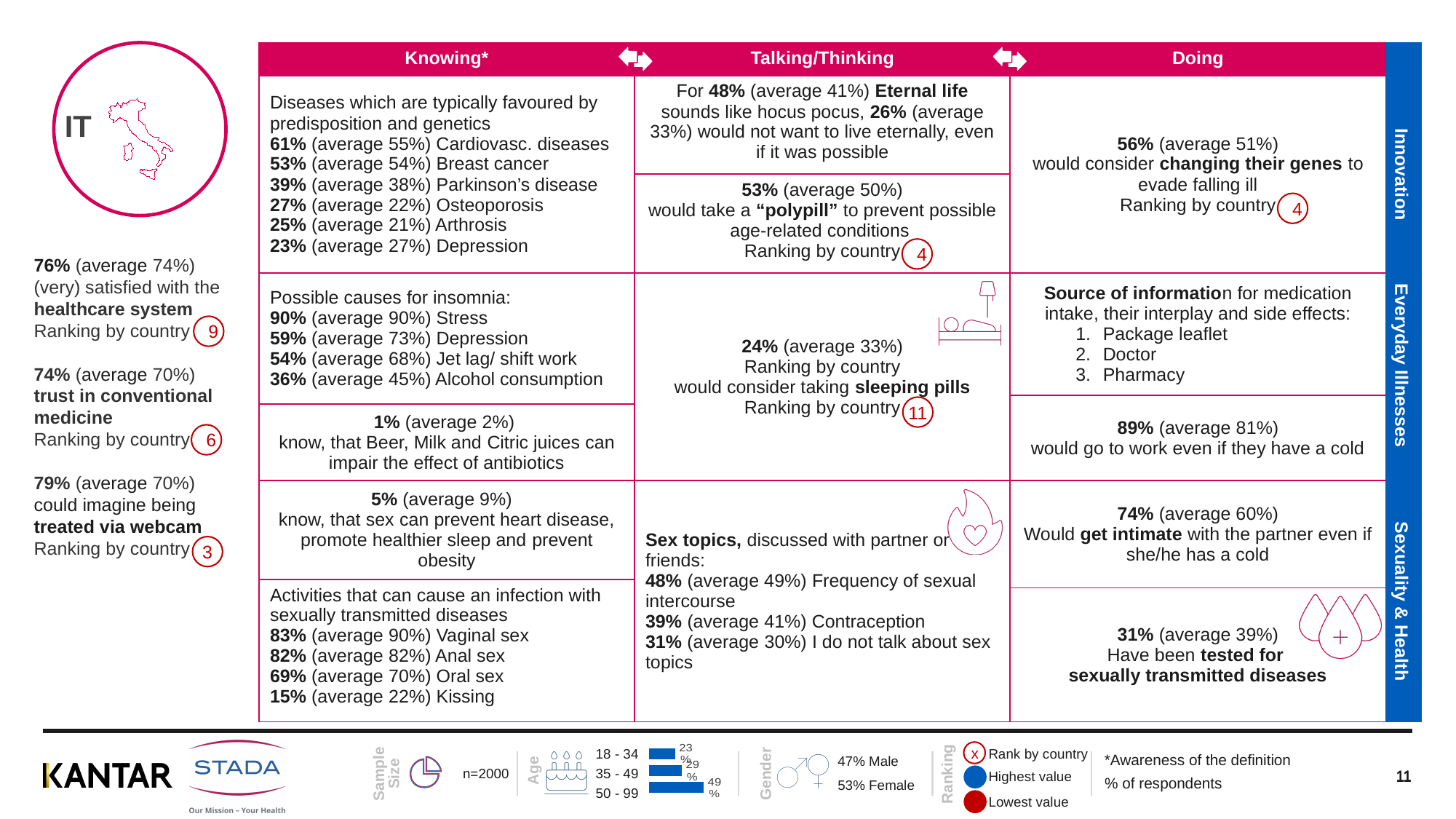
What does the small bar chart at the bottom of the slide show? Age distribution of the sample In the Age bar chart at the bottom of the slide, what is the difference between the value for 50 - 99 and the value for 18 - 34? 26% In the Age bar chart at the bottom of the slide, which age group has the lowest value? 18 - 34 How many age groups are shown in the Age bar chart at the bottom of the slide? 3 In the Age bar chart at the bottom of the slide, which age group has the highest value? 50 - 99 In the Age bar chart at the bottom of the slide, what is the value for the 35 - 49 age group? 29% In the Age bar chart at the bottom of the slide, what is the value for the 18 - 34 age group? 23% What kind of chart is the Age chart at the bottom of the slide? bar chart In the Age bar chart at the bottom of the slide, do the values rise or fall as the age groups go from 18 - 34 to 50 - 99? rise In the Age bar chart at the bottom of the slide, what is the value for the 50 - 99 age group? 49% In the Age bar chart at the bottom of the slide, which is larger: the value for 35 - 49 or the value for 18 - 34? 35 - 49